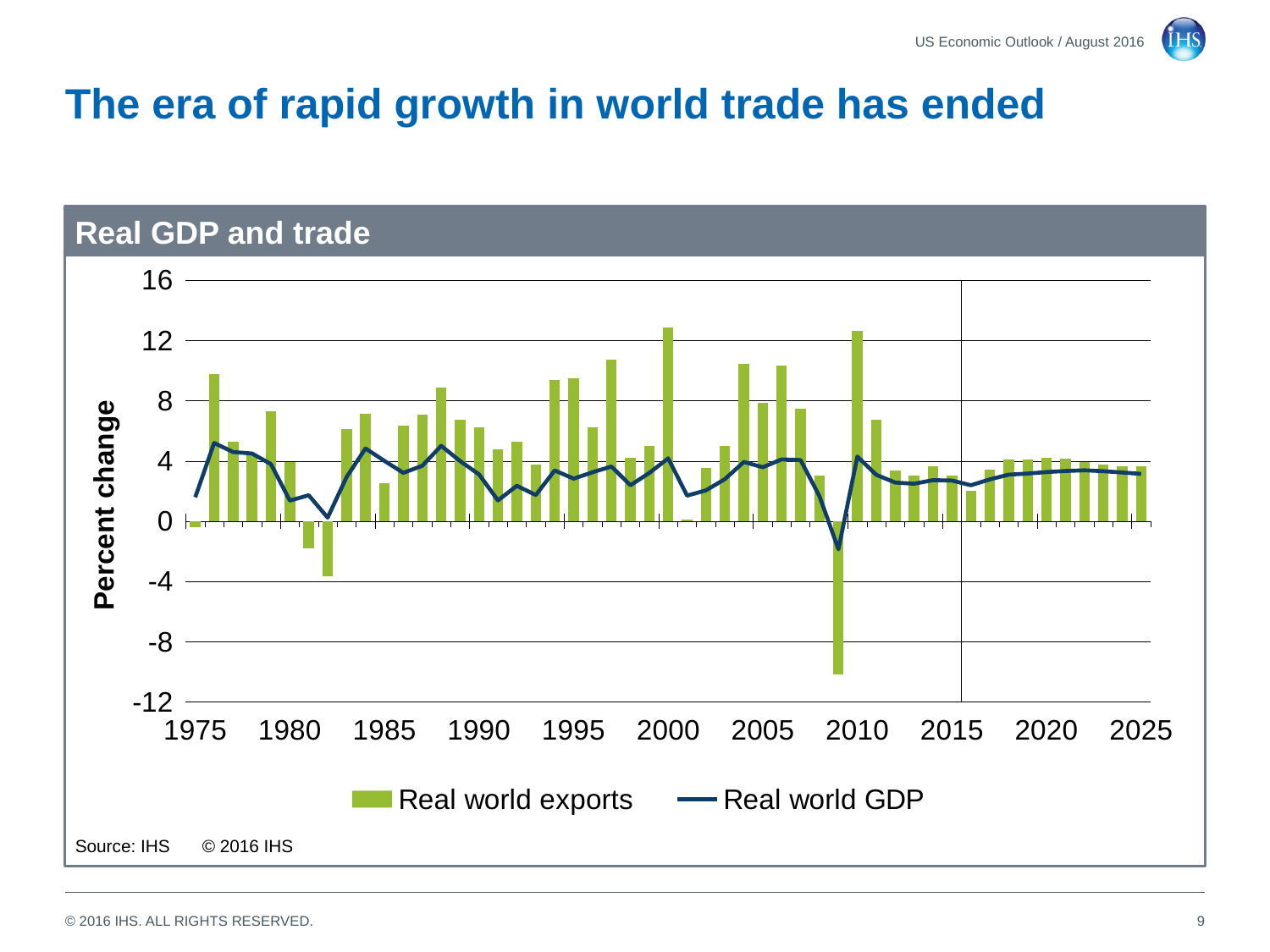
Is the value for Real world exports in 2009 greater or less than -8? less Is the value for Real world exports in 2000 greater or less than 12? greater Which is larger, the value for Real world exports in 2009 or in 2010? 2010 What kind of chart is shown on the slide? A combined bar and line chart What is the label on the vertical axis? Percent change What is the title of the chart? Real GDP and trade Is the value for Real world exports in 1976 greater or less than 8? greater In which year is the value for Real world exports lowest? 2009 How many series does the legend list? 2 Does the Real world GDP line rise or fall between 2007 and 2009? fall